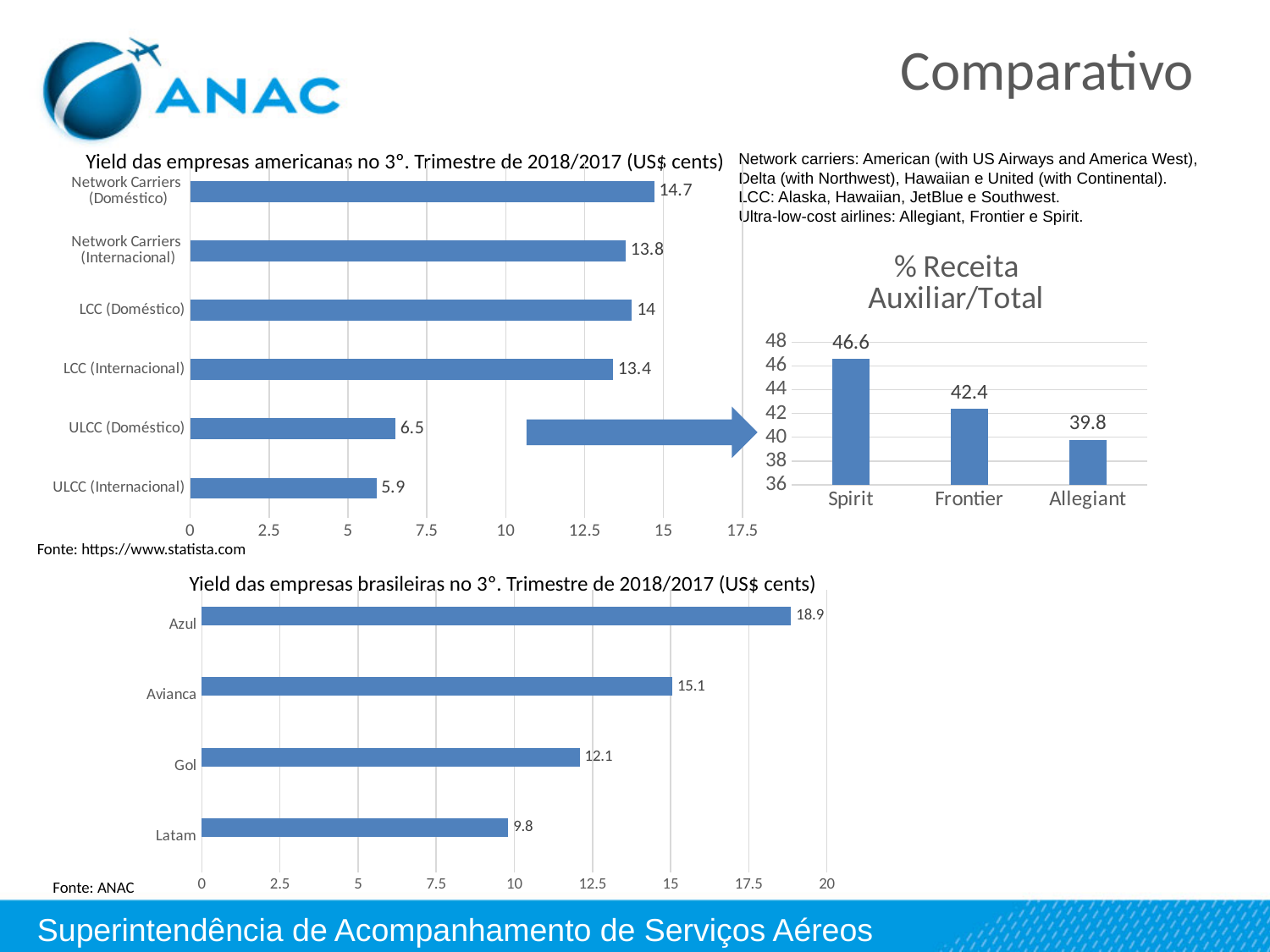
What kind of chart is 'Yield das empresas brasileiras no 3°. Trimestre de 2018/2017 (US$ cents)'? Bar chart In the chart 'Yield das empresas americanas no 3°. Trimestre de 2018/2017 (US$ cents)', how many categories are shown? 6 In the chart 'Yield das empresas americanas no 3°. Trimestre de 2018/2017 (US$ cents)', what is the difference between LCC (Doméstico) and LCC (Internacional)? 0.6 In the chart '% Receita Auxiliar/Total', which category has the highest value? Spirit In the chart 'Yield das empresas brasileiras no 3°. Trimestre de 2018/2017 (US$ cents)', what is the difference between Azul and Latam? 9.1 In the chart 'Yield das empresas americanas no 3°. Trimestre de 2018/2017 (US$ cents)', what is the value for Network Carriers (Doméstico)? 14.7 In the chart 'Yield das empresas brasileiras no 3°. Trimestre de 2018/2017 (US$ cents)', which category has the highest value? Azul In the chart 'Yield das empresas americanas no 3°. Trimestre de 2018/2017 (US$ cents)', which is larger: ULCC (Doméstico) or ULCC (Internacional)? ULCC (Doméstico) In the chart '% Receita Auxiliar/Total', what is the value for Frontier? 42.4 In the chart '% Receita Auxiliar/Total', what is the difference between Spirit and Allegiant? 6.8 In the chart 'Yield das empresas americanas no 3°. Trimestre de 2018/2017 (US$ cents)', which category has the lowest value? ULCC (Internacional) In the chart 'Yield das empresas brasileiras no 3°. Trimestre de 2018/2017 (US$ cents)', what is the value for Gol? 12.1